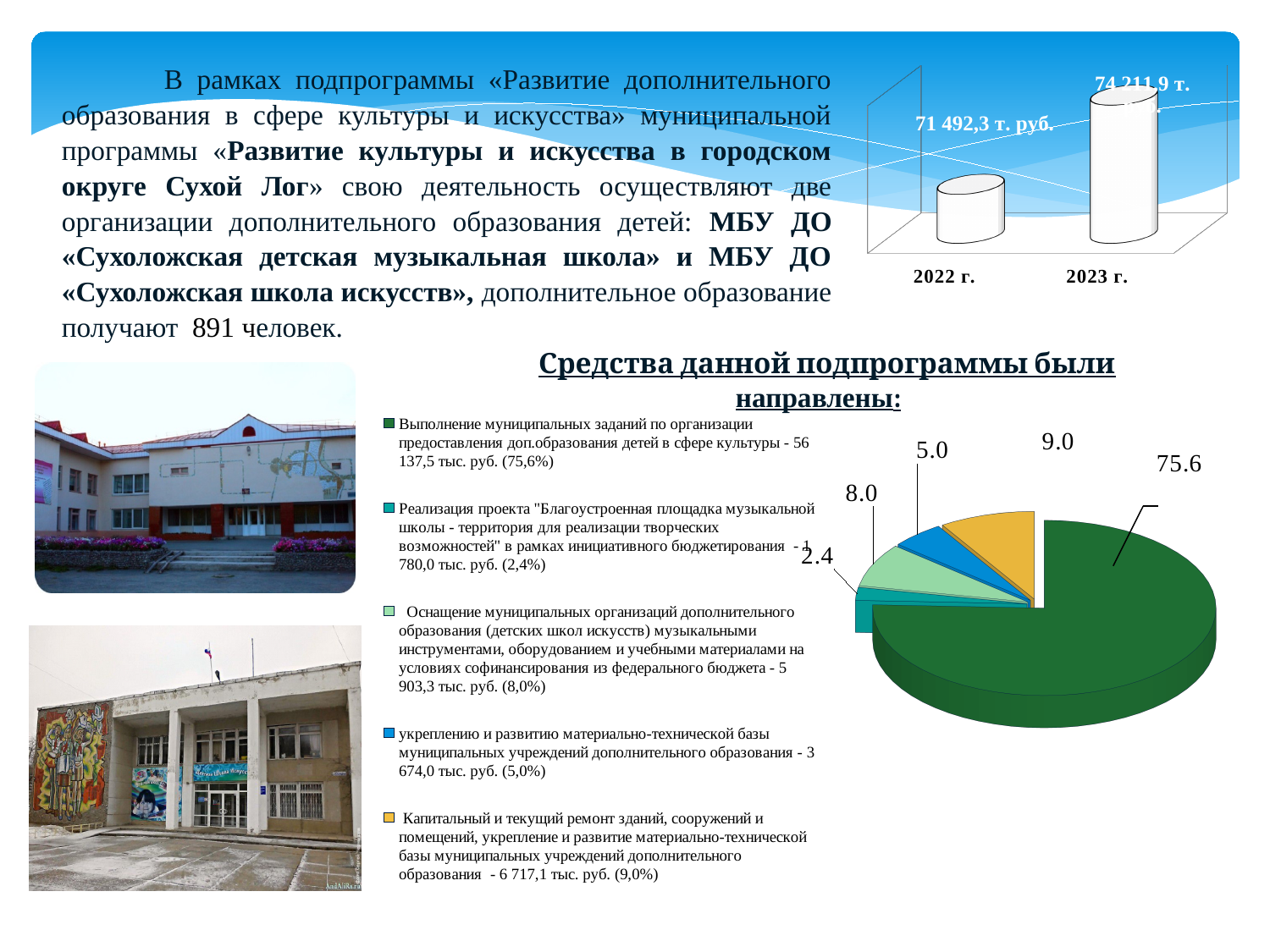
What kind of chart is shown at the top right of the slide? bar chart What kind of chart is shown under the title «Средства данной подпрограммы были направлены:»? pie chart In the pie chart «Средства данной подпрограммы были направлены:», how many entries does the legend list? 5 In the pie chart «Средства данной подпрограммы были направлены:», how many slices are there? 5 In the bar chart at the top right of the slide, do the values rise or fall from 2022 г. to 2023 г.? rise In the pie chart «Средства данной подпрограммы были направлены:», what is the difference between the 9.0 slice and the 5.0 slice? 4.0 In the bar chart at the top right of the slide, how many categories are shown? 2 In the pie chart «Средства данной подпрограммы были направлены:», which is larger, the 8.0 slice or the 9.0 slice? 9.0 In the pie chart «Средства данной подпрограммы были направлены:», what is the smallest slice's value? 2.4 In the bar chart at the top right of the slide, which year has the higher value, 2022 г. or 2023 г.? 2023 г. In the pie chart «Средства данной подпрограммы были направлены:», what is the largest slice's value? 75.6 In the bar chart at the top right of the slide, what is the value for 2022 г.? 71 492,3 т. руб.